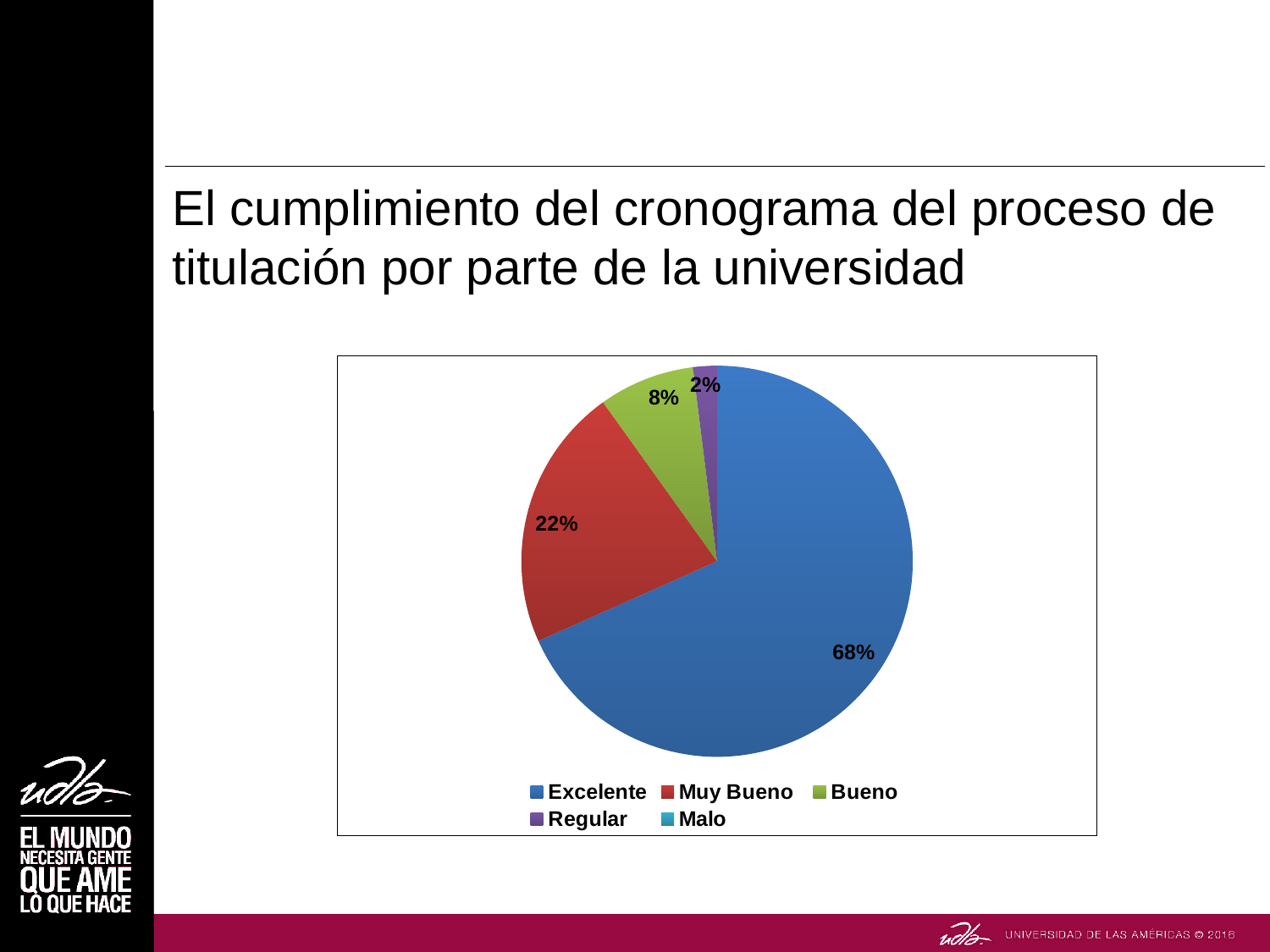
How many categories does the legend list? 5 Which category has the largest slice of the pie? Excelente What kind of chart is shown on the slide? pie chart What is the difference between the Excelente and Muy Bueno shares? 46% Which of the labelled slices is the smallest? Regular What share of the pie does Muy Bueno have? 22% What share of the pie does Regular have? 2% What share of the pie does Bueno have? 8% What colour is the Excelente slice? blue Which is larger, the Bueno slice or the Muy Bueno slice? Muy Bueno Which legend entry has no visible slice in the pie? Malo